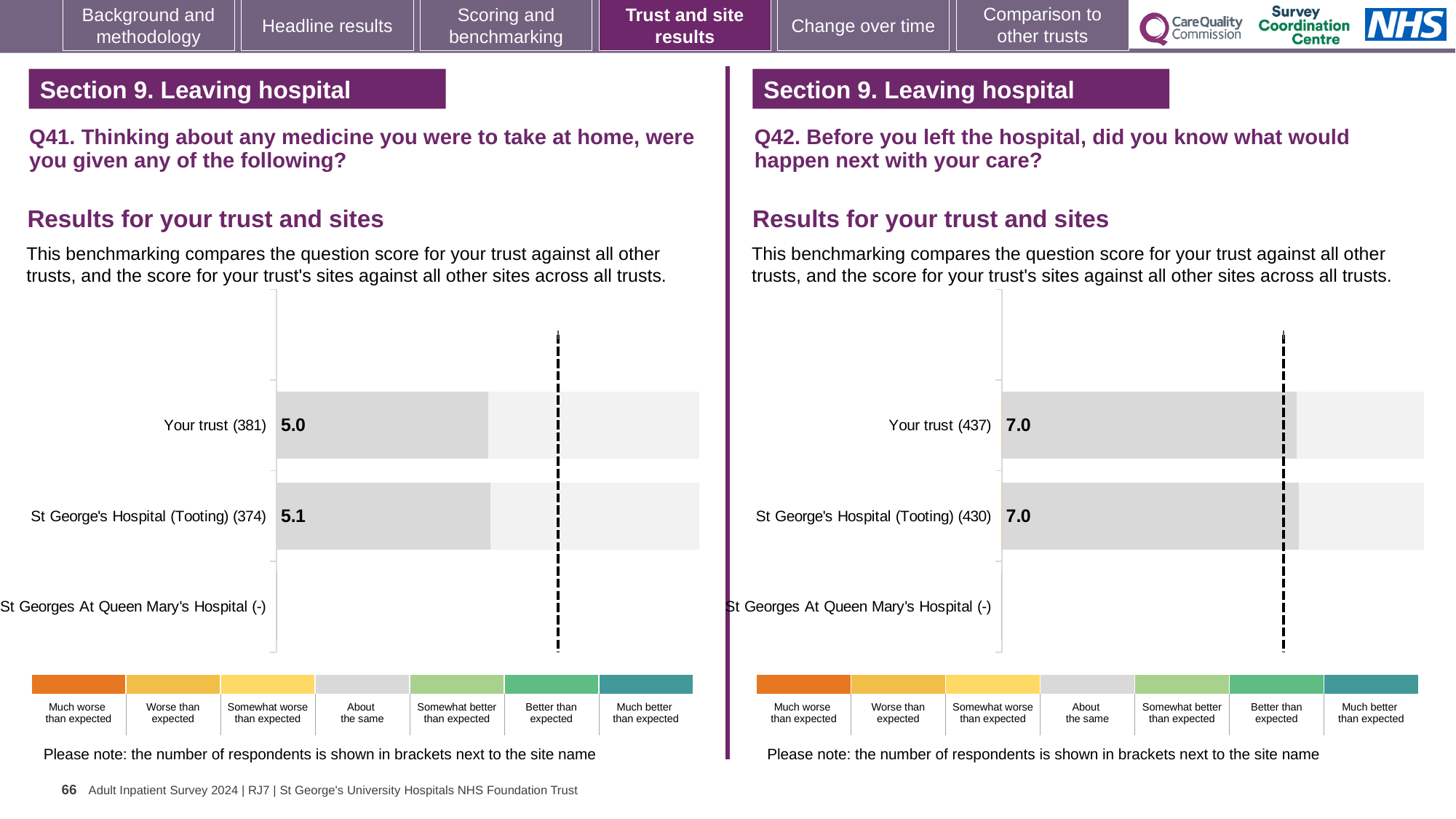
How many benchmark categories are shown in the colour key below the Q42 chart (right)? 7 On the Q41 chart (left), what is the difference between the scores for St George's Hospital (Tooting) and Your trust? 0.1 On the Q42 chart (right), what is the score for St George's Hospital (Tooting)? 7.0 On the Q42 chart (right), what is the difference between the scores for Your trust and St George's Hospital (Tooting)? 0.0 On the Q42 chart (right), what is the score for Your trust? 7.0 On the Q41 chart (left), how many respondents are shown in brackets for Your trust? 381 What kind of chart is the Q42 chart (right)? Bar chart How many categories (sites) are listed on the Q41 chart (left)? 3 On the Q41 chart (left), what is the score for St George's Hospital (Tooting)? 5.1 On the Q42 chart (right), how many respondents are shown in brackets for St George's Hospital (Tooting)? 430 On the Q41 chart (left), which site has no score shown? St Georges At Queen Mary's Hospital On the Q41 chart (left), what is the score for Your trust? 5.0